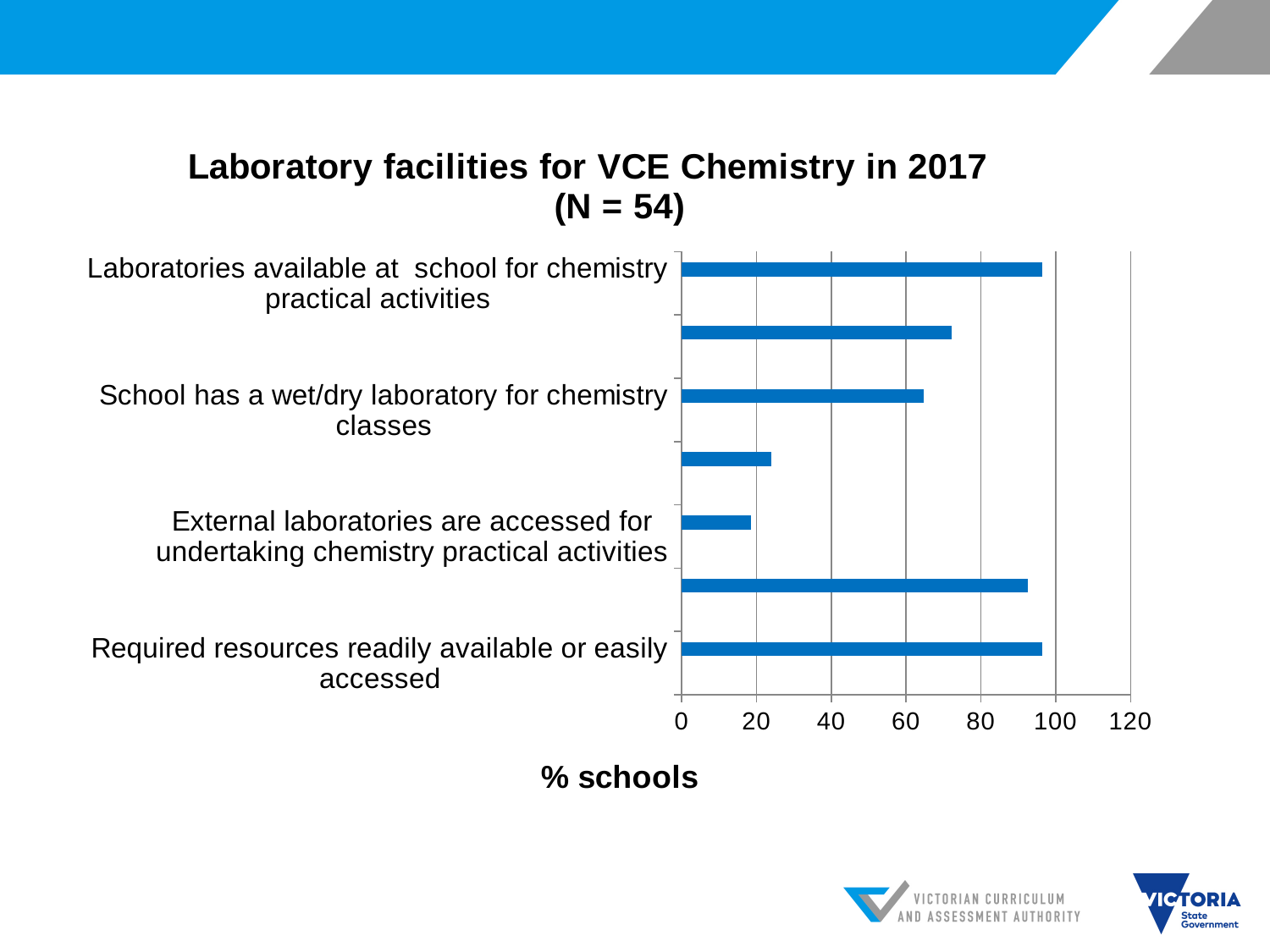
Which has the larger value: 'School has a wet/dry laboratory for chemistry classes' or 'External laboratories are accessed for undertaking chemistry practical activities'? School has a wet/dry laboratory for chemistry classes Is the value for 'Laboratories available at school for chemistry practical activities' greater or less than 100? less What kind of chart is shown on the slide? bar chart Is the value for 'External laboratories are accessed for undertaking chemistry practical activities' greater or less than 40? less Which has the larger value: 'Required resources readily available or easily accessed' or 'External laboratories are accessed for undertaking chemistry practical activities'? Required resources readily available or easily accessed What is the label on the horizontal axis of the chart? % schools Is the value for 'School has a wet/dry laboratory for chemistry classes' greater or less than 80? less What is the title of the chart? Laboratory facilities for VCE Chemistry in 2017 (N = 54) How many bars are plotted in the chart? 7 Which has the larger value: 'Laboratories available at school for chemistry practical activities' or 'School has a wet/dry laboratory for chemistry classes'? Laboratories available at school for chemistry practical activities